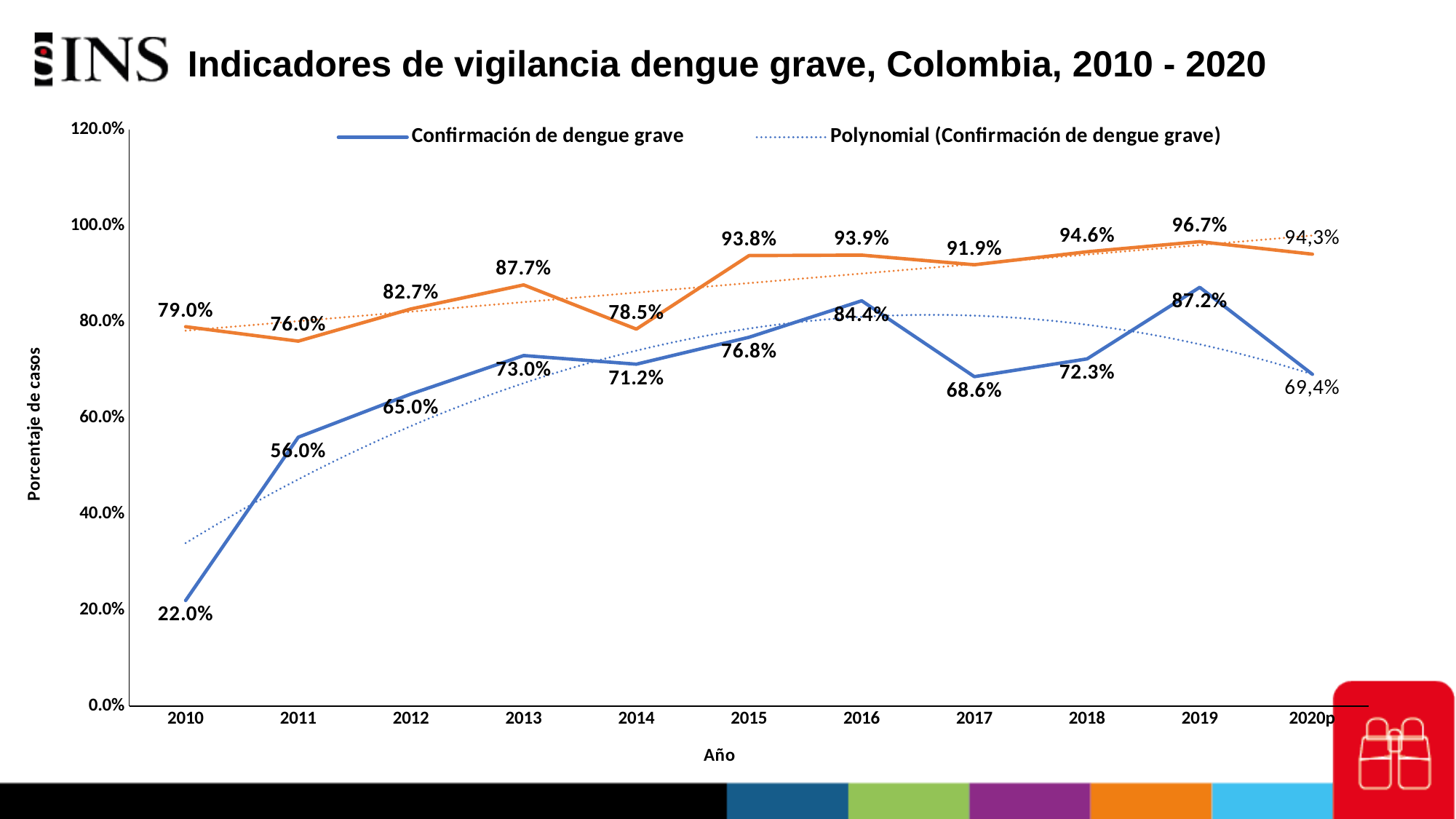
What is the difference between the Confirmación de dengue grave values for 2019 and 2017? 18.6 percentage points In which year is Confirmación de dengue grave highest? 2019 How many entries does the legend list? 2 How many years are shown on the x axis? 11 Which year has a higher Confirmación de dengue grave value, 2013 or 2014? 2013 In which year is Confirmación de dengue grave lowest? 2010 What value does the orange line show for 2019? 96.7% Does Confirmación de dengue grave rise or fall from 2010 to 2013? Rise What kind of chart is shown on the slide? Line chart What is the value of Confirmación de dengue grave in 2016? 84.4% What is the value of Confirmación de dengue grave in 2020p? 69,4% What is the value of Confirmación de dengue grave in 2010? 22.0%